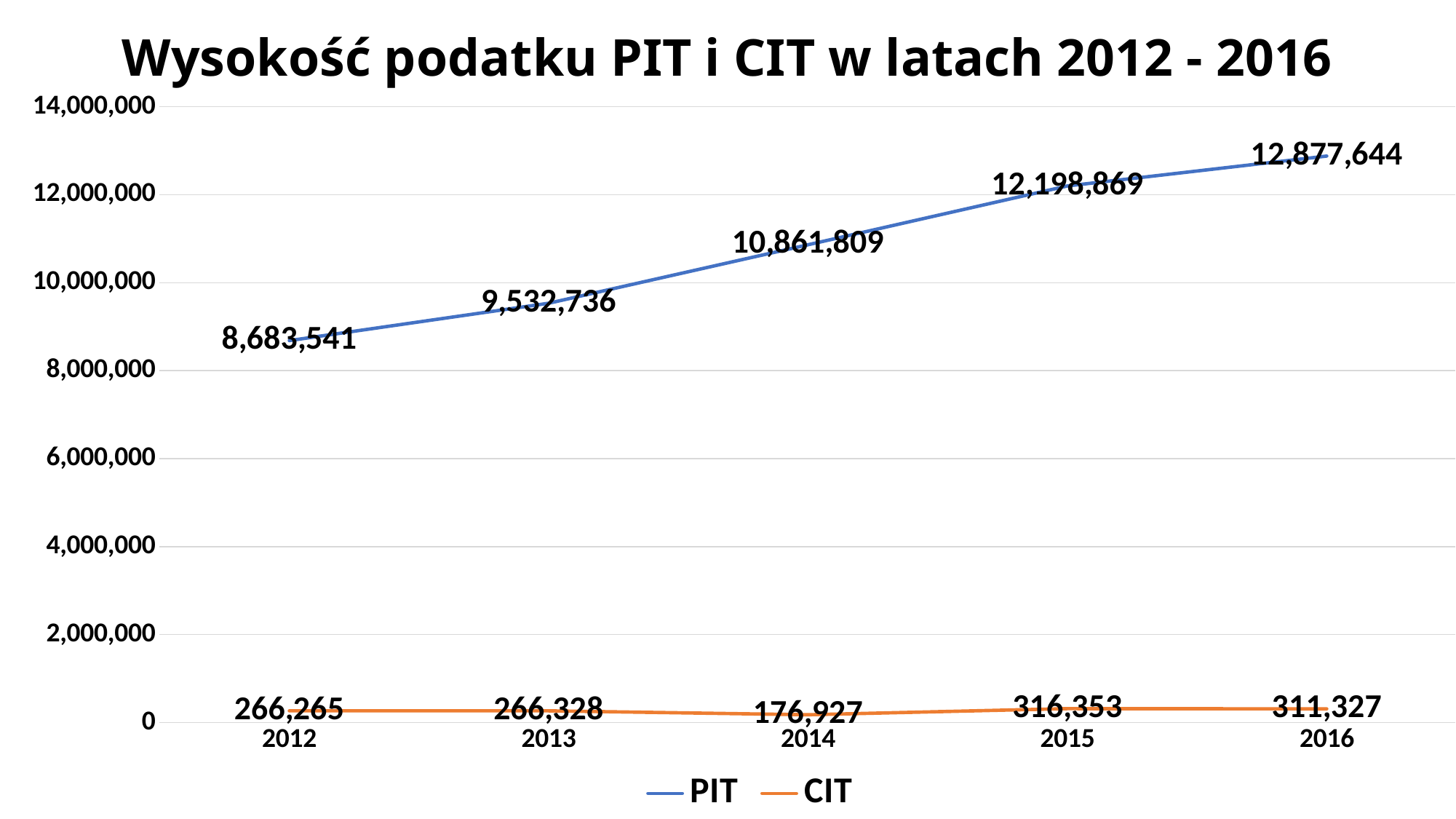
Which is larger, the CIT value in 2013 or the CIT value in 2016? 2016 What is the difference between the CIT value in 2015 and the CIT value in 2014? 139,426 Does the PIT series rise or fall from 2012 to 2016? rise Is the PIT value for 2013 greater or less than 10,000,000? less What is the difference between the PIT value in 2016 and the PIT value in 2012? 4,194,103 In which year is the CIT value highest? 2015 What is the PIT value for 2016? 12,877,644 In which year is the CIT value lowest? 2014 What is the PIT value for 2014? 10,861,809 What is the CIT value for 2012? 266,265 How many series does the legend list? 2 What type of chart is shown on the slide? line chart